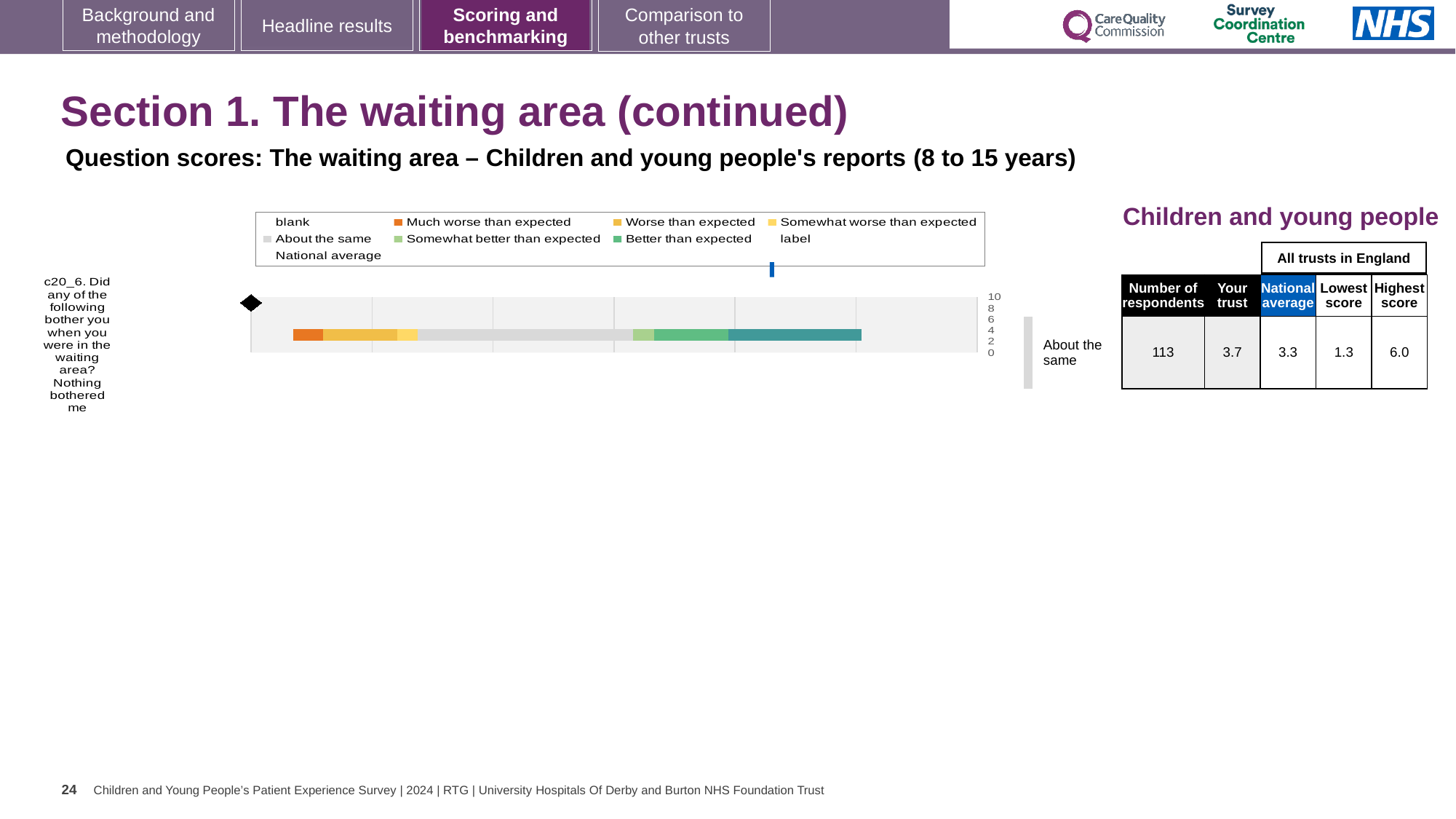
What is the number of respondents for question c20_6 in the Children and young people table? 113 How many questions (categories) are plotted in the chart? 1 What is the highest score among all trusts in England for question c20_6? 6.0 Which is larger for question c20_6, the 'Your trust' score or the national average? Your trust What kind of chart is shown on the slide? bar chart What is the difference between the highest score and the lowest score for question c20_6? 4.7 What benchmark category is shown to the right of the bar for question c20_6? About the same How many entries does the chart legend list? 9 Which legend entry is shown in orange? Much worse than expected What is the 'Your trust' score for question c20_6? 3.7 What is the national average score for question c20_6? 3.3 What is the lowest score among all trusts in England for question c20_6? 1.3